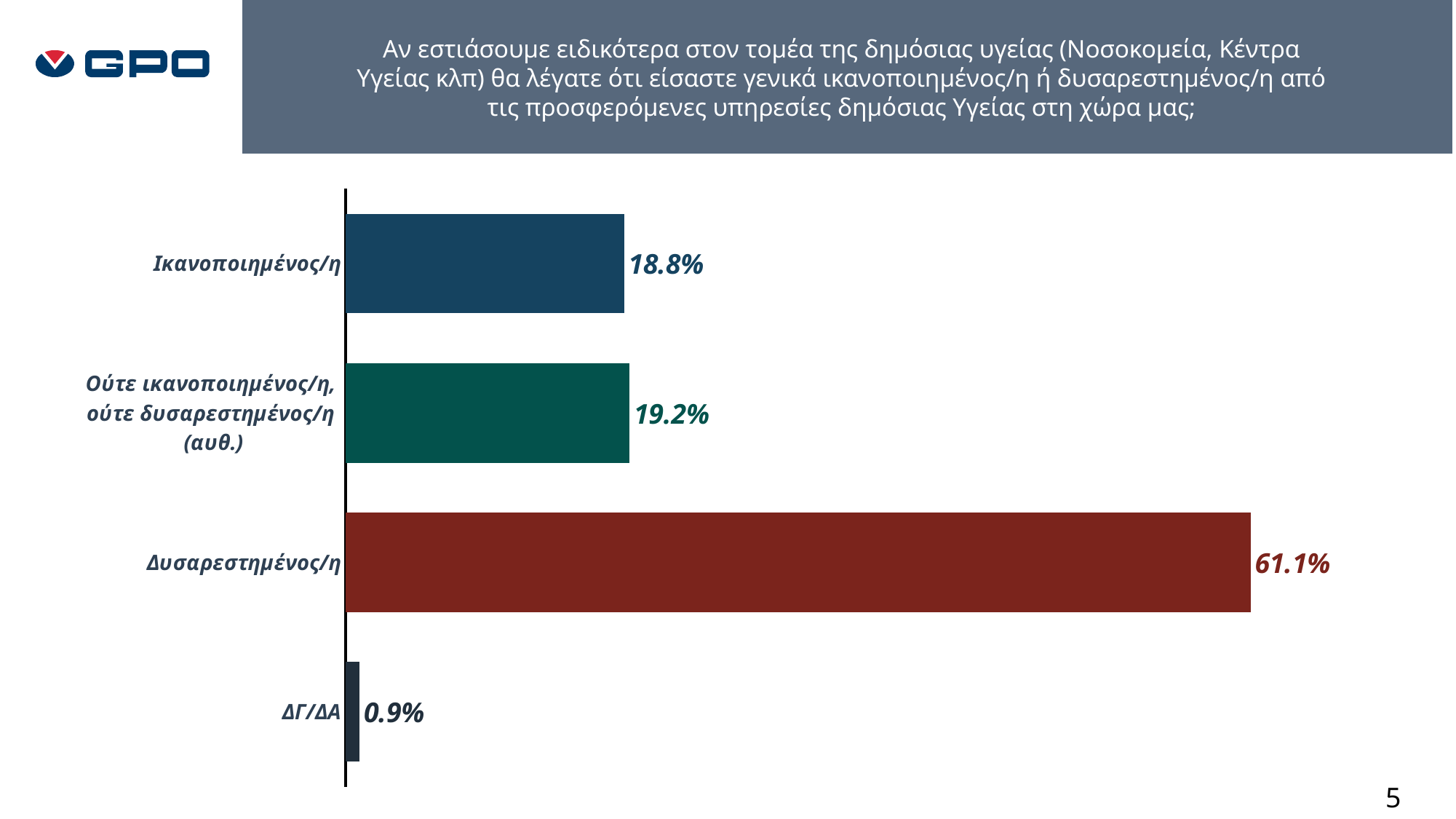
How many categories are shown in the chart? 4 What is the difference between the values for Δυσαρεστημένος/η and Ικανοποιημένος/η? 42.3% Which is larger, the value for Δυσαρεστημένος/η or the value for Ικανοποιημένος/η? Δυσαρεστημένος/η What is the value for Ούτε ικανοποιημένος/η, ούτε δυσαρεστημένος/η (αυθ.)? 19.2% What is the value for ΔΓ/ΔΑ? 0.9% What is the value for Ικανοποιημένος/η? 18.8% Which category has the highest value? Δυσαρεστημένος/η Which category has the lowest value? ΔΓ/ΔΑ What is the value for Δυσαρεστημένος/η? 61.1% What is the difference between the values for Ούτε ικανοποιημένος/η, ούτε δυσαρεστημένος/η (αυθ.) and Ικανοποιημένος/η? 0.4% What colour is the bar for Δυσαρεστημένος/η? Dark red What kind of chart is shown on the slide? Bar chart